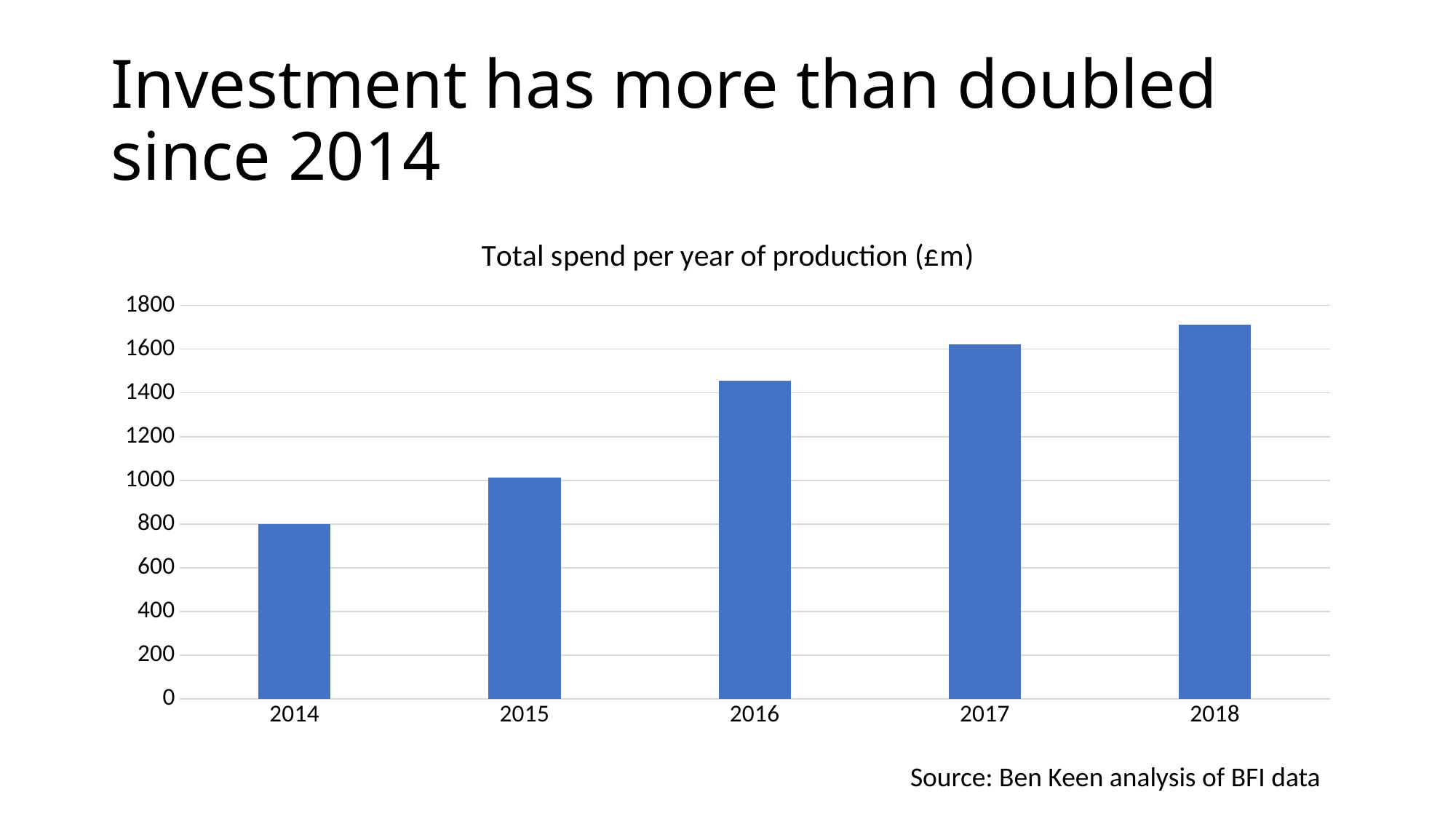
How many years are plotted on the chart? 5 Is the value for 2015 greater or less than 800? greater Do the values rise or fall from 2014 to 2018? Rise What is the title of the chart? Total spend per year of production (£m) Which year has the larger total spend, 2015 or 2016? 2016 Is the value for 2018 greater or less than 1800? less Is the value for 2016 greater or less than 1400? greater Which year has the lowest total spend? 2014 What kind of chart is shown on the slide? Bar chart Which year has the highest total spend? 2018